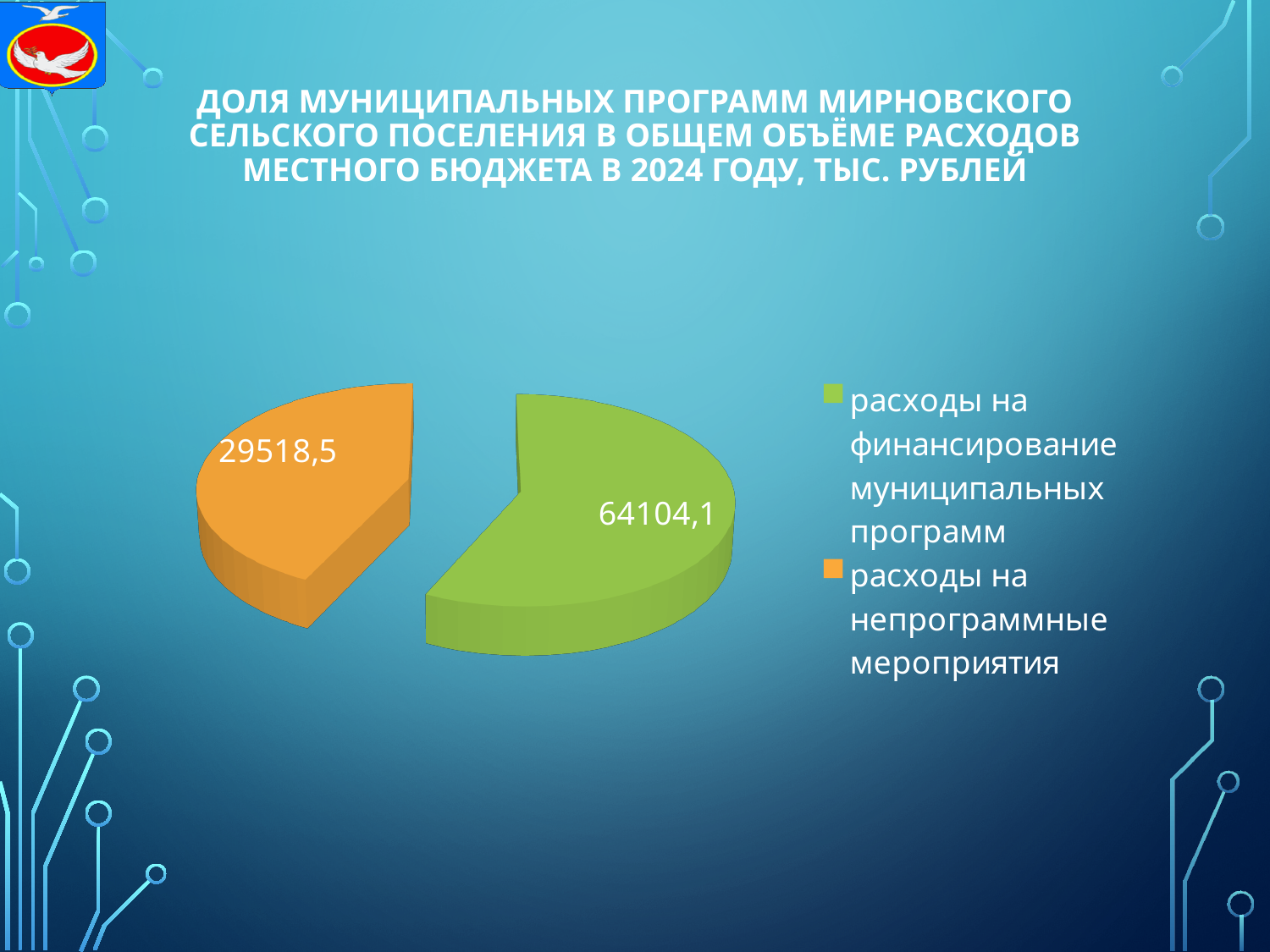
What is the value for расходы на непрограммные мероприятия? 29518,5 How many slices does the pie chart have? 2 In what units are the values in the chart given, according to the title? тыс. рублей What is the value for расходы на финансирование муниципальных программ? 64104,1 How many entries does the legend list? 2 What type of chart is shown on the slide? pie chart What is the total of the two slices in the pie chart? 93622,6 Which is larger: расходы на финансирование муниципальных программ or расходы на непрограммные мероприятия? расходы на финансирование муниципальных программ Which category has the smallest slice of the pie? расходы на непрограммные мероприятия Which category has the largest slice of the pie? расходы на финансирование муниципальных программ What colour is the slice for расходы на непрограммные мероприятия? orange What is the difference between расходы на финансирование муниципальных программ and расходы на непрограммные мероприятия? 34585,6